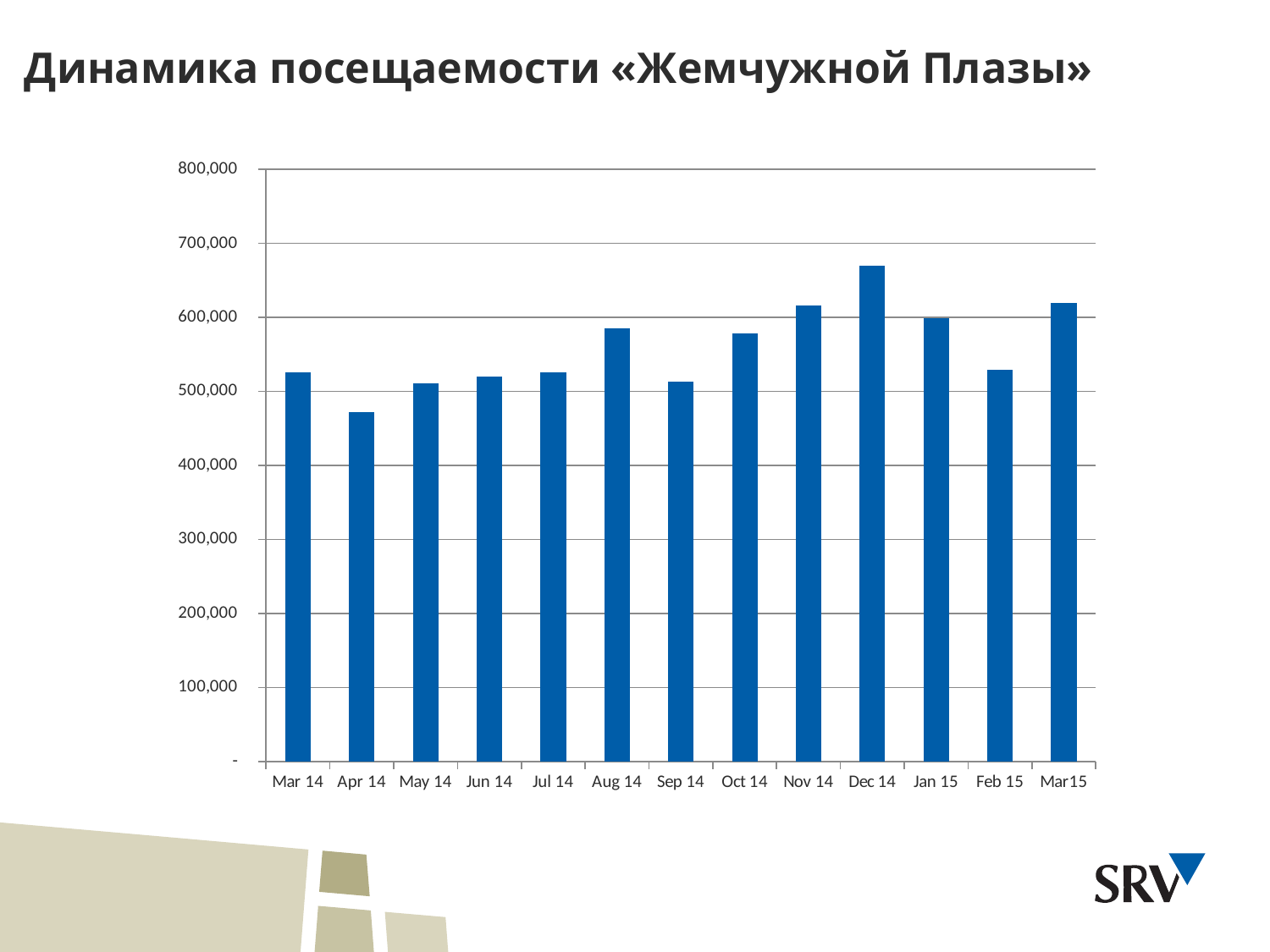
Is the value for Mar 15 greater or less than 600,000? greater What kind of chart is shown on the slide? bar chart Which is larger, the value for Nov 14 or the value for Dec 14? Dec 14 Is the value for Aug 14 greater or less than 600,000? less Which is larger, the value for Mar 14 or the value for Apr 14? Mar 14 Is the value for Apr 14 greater or less than 500,000? less What is the title of the slide? Динамика посещаемости «Жемчужной Плазы» Which month has the lowest value? Apr 14 Do the values rise or fall from Sep 14 to Dec 14? rise How many months are plotted on the x axis? 13 Which month has the highest value? Dec 14